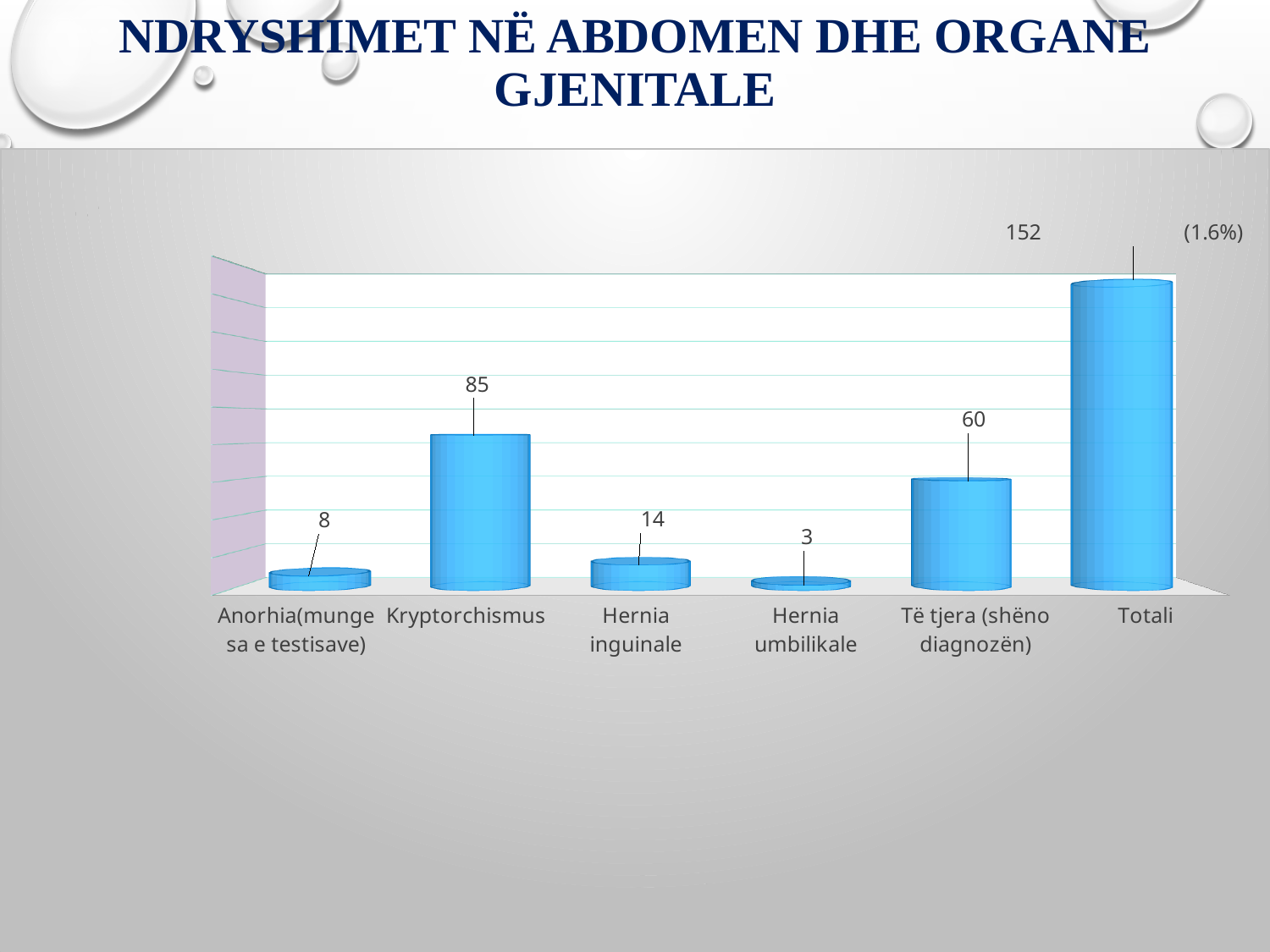
What is the value for Të tjera (shëno diagnozën)? 60 What percentage is printed next to the Totali bar? (1.6%) What is the value for Totali? 152 What is the value for Anorhia(mungesa e testisave)? 8 Excluding Totali, which category has the highest value? Kryptorchismus What is the value for Hernia umbilikale? 3 Which category has the lowest value? Hernia umbilikale What is the difference between the values for Kryptorchismus and Të tjera (shëno diagnozën)? 25 Which is larger, the value for Hernia inguinale or the value for Anorhia(mungesa e testisave)? Hernia inguinale How many categories are shown on the x axis? 6 What kind of chart is shown on the slide? bar chart What is the value for Kryptorchismus? 85